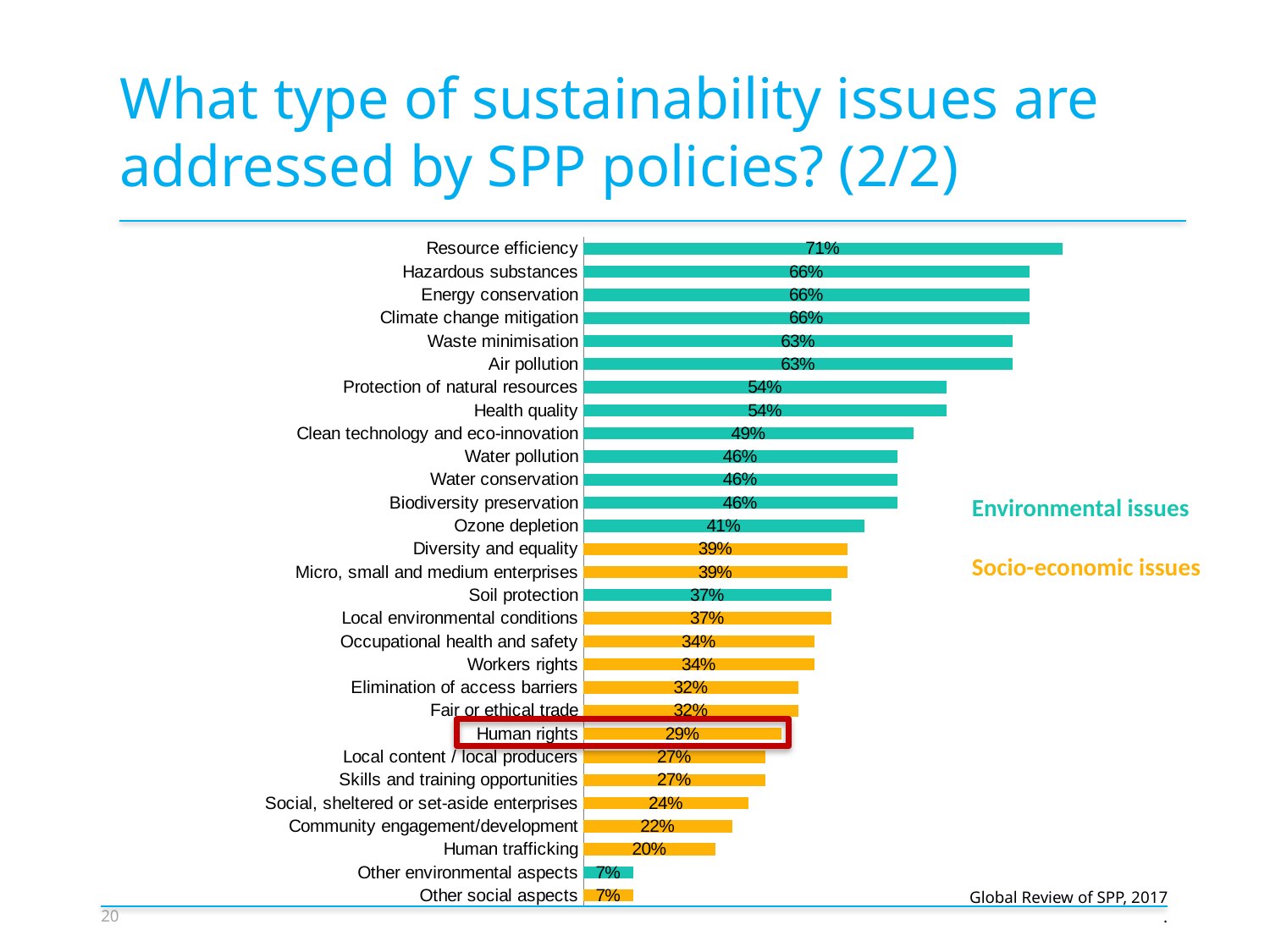
What is the value for Human trafficking? 20% What is the value for Resource efficiency? 71% What is the value for Human rights? 29% Which category has the highest value? Resource efficiency How many categories are shown on the chart? 29 What is the lowest value shown on the chart? 7% What is the value for Ozone depletion? 41% What is the difference between the values for Human rights and Human trafficking? 9% What kind of chart is shown on the slide? Bar chart Which category is highlighted with a red box on the chart? Human rights Which is larger, the value for Soil protection or the value for Workers rights? Soil protection What is the difference between the values for Resource efficiency and Waste minimisation? 8%